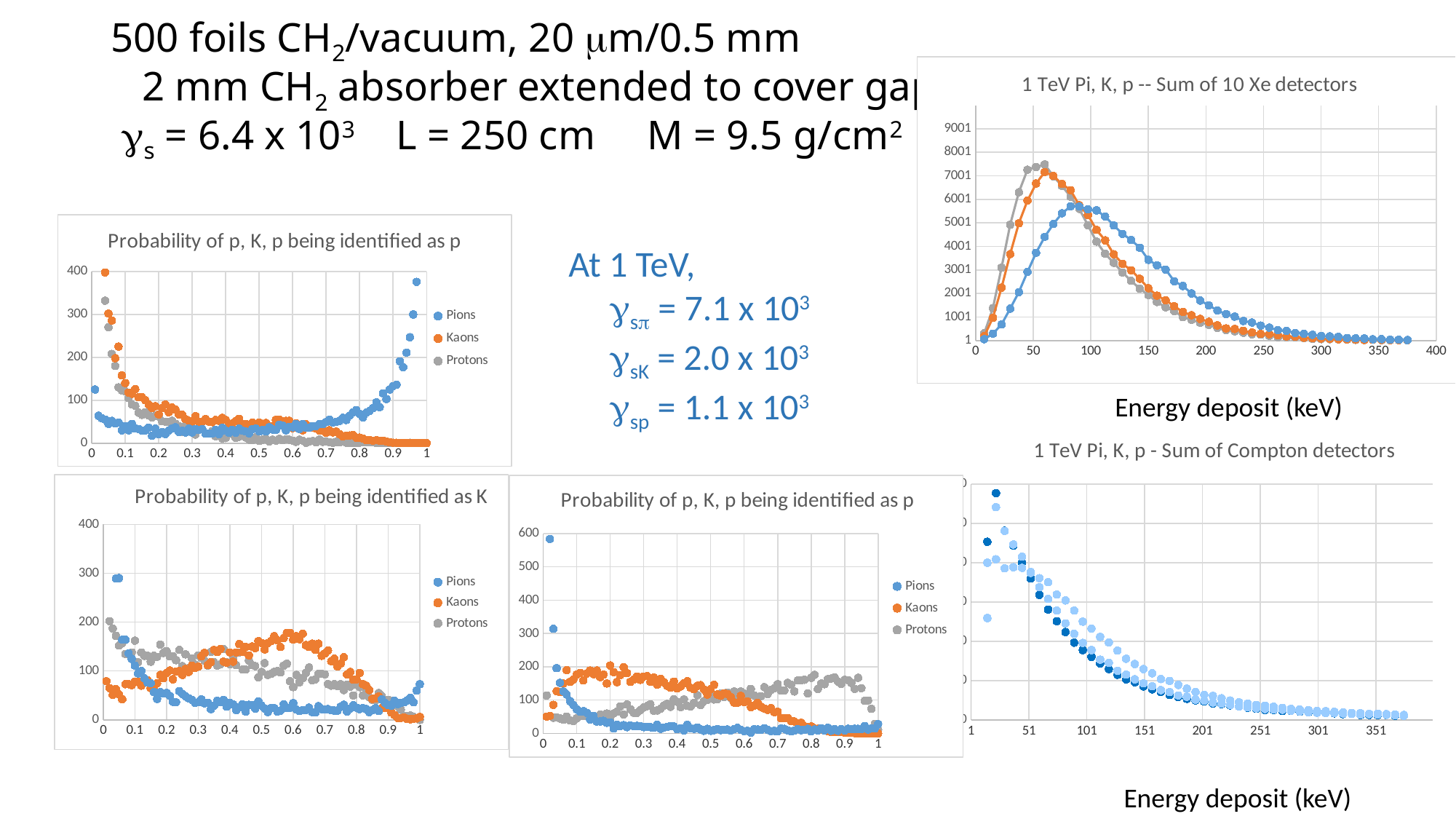
In the top-left chart titled "Probability of p, K, p being identified as p", which series has the highest value near x = 0? Kaons What are the legend entries in the chart titled "Probability of p, K, p being identified as K"? Pions, Kaons, Protons In the top-left chart titled "Probability of p, K, p being identified as p", which series has the highest value near x = 1? Pions What kind of chart is the top-left chart titled "Probability of p, K, p being identified as p"? scatter chart In the chart titled "1 TeV Pi, K, p -- Sum of 10 Xe detectors", which series reaches its peak at a higher energy deposit, Pions or Kaons? Pions In the bottom-middle chart titled "Probability of p, K, p being identified as p", is the highest Pions value greater or less than 500? greater In the chart titled "1 TeV Pi, K, p -- Sum of 10 Xe detectors", is the peak value of the Pions (blue) series greater or less than 6001? less In the chart titled "1 TeV Pi, K, p -- Sum of 10 Xe detectors", is the peak value of the Protons (grey) series greater or less than 7001? greater How many series does the legend list in the chart titled "Probability of p, K, p being identified as K"? 3 What is the x-axis label shown under the chart titled "1 TeV Pi, K, p - Sum of Compton detectors"? Energy deposit (keV) In the chart titled "1 TeV Pi, K, p -- Sum of 10 Xe detectors", do the values rise or fall as energy deposit increases from 150 to 350? fall